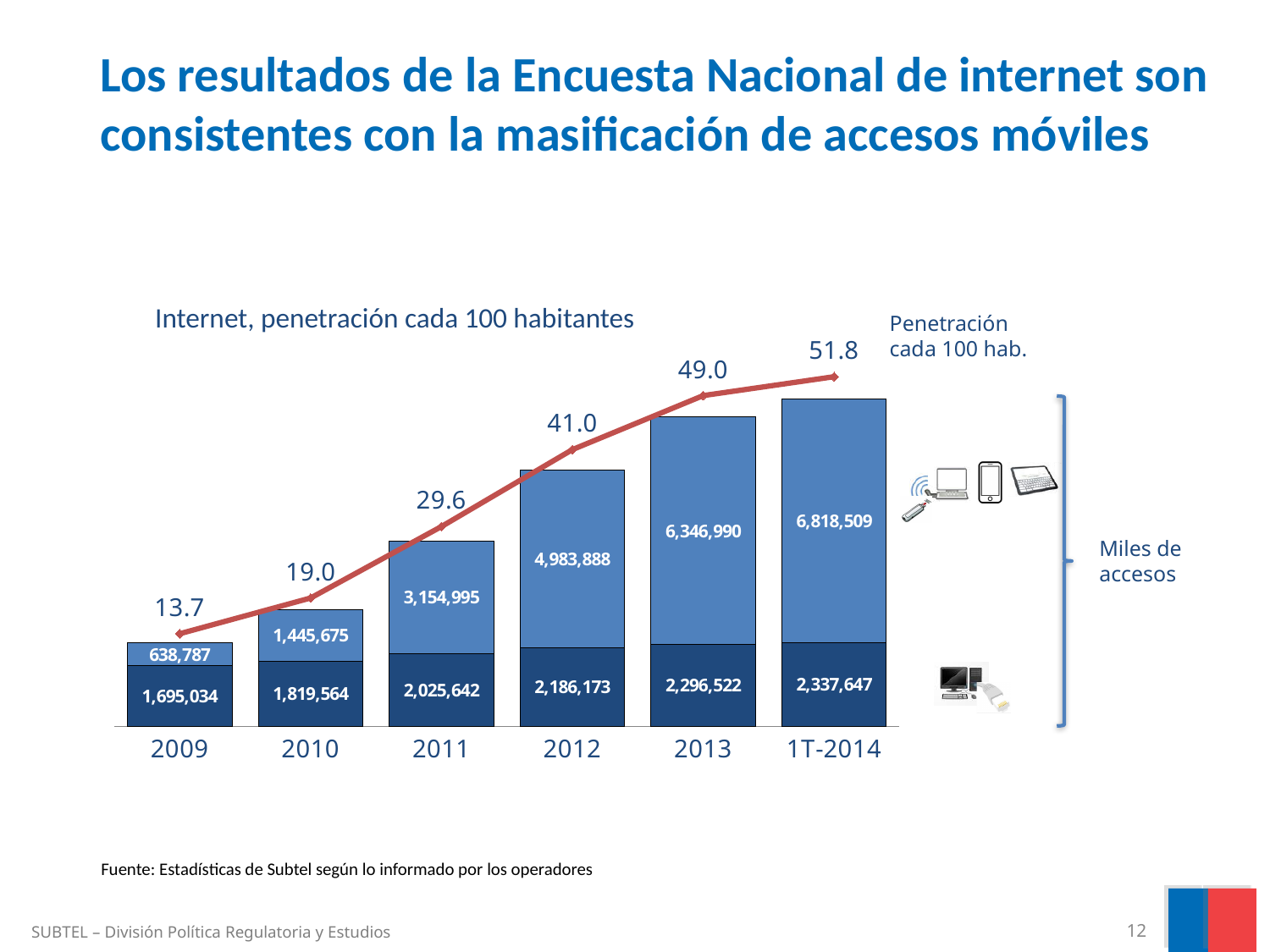
Does the penetration line rise or fall from 2009 to 1T-2014? Rises What kind of chart is this? Stacked bar chart with a line What value does the dark blue (lower) bar segment show for 2013? 2,296,522 What value does the light blue (upper) bar segment show for 2011? 3,154,995 What is the difference in penetration per 100 inhabitants between 2013 and 2009? 35.3 How many periods are shown on the x axis? 6 Which is larger: the light blue segment for 2012 or the light blue segment for 2013? 2013 What is the total of the stacked bar for 1T-2014? 9,156,156 Which year has the lowest value for the light blue (upper) bar segment? 2009 Which period has the highest penetration per 100 inhabitants on the line? 1T-2014 What is the title of the chart? Internet, penetración cada 100 habitantes What is the penetration per 100 inhabitants shown for 2012? 41.0